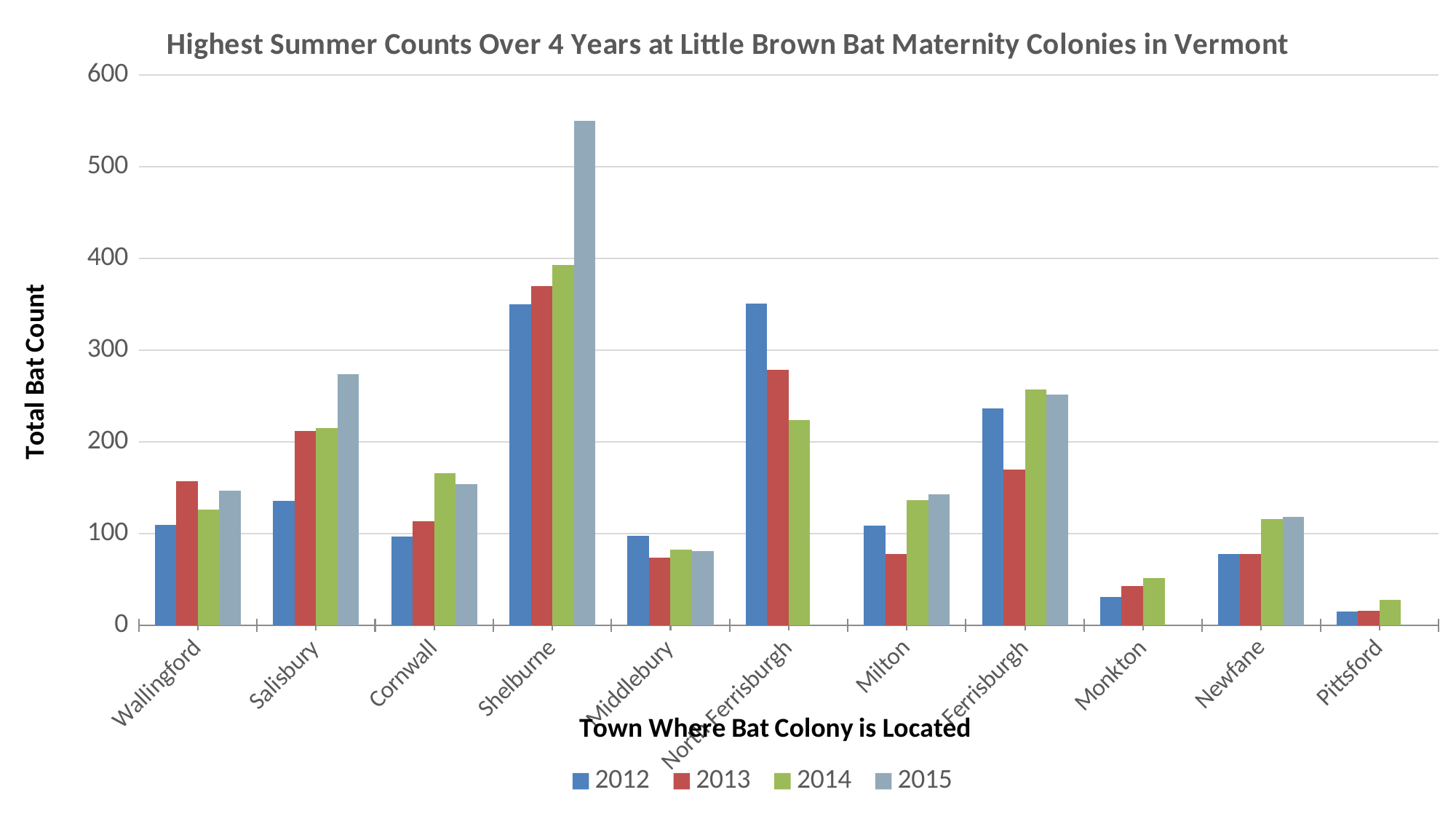
What is the title of the chart? Highest Summer Counts Over 4 Years at Little Brown Bat Maternity Colonies in Vermont Which town has the highest 2015 bar? Shelburne How many towns are shown on the x axis of the chart? 11 What kind of chart is shown on the slide? bar chart Is the 2014 value for Monkton greater or less than 100? less Which town has the lowest 2013 bar? Pittsford Is the 2015 value for Shelburne greater or less than 500? greater Is the 2012 value for North Ferrisburgh greater or less than 300? greater What is the label on the y axis of the chart? Total Bat Count Which is larger, the 2015 value for Salisbury or the 2015 value for Cornwall? Salisbury How many series does the legend list? 4